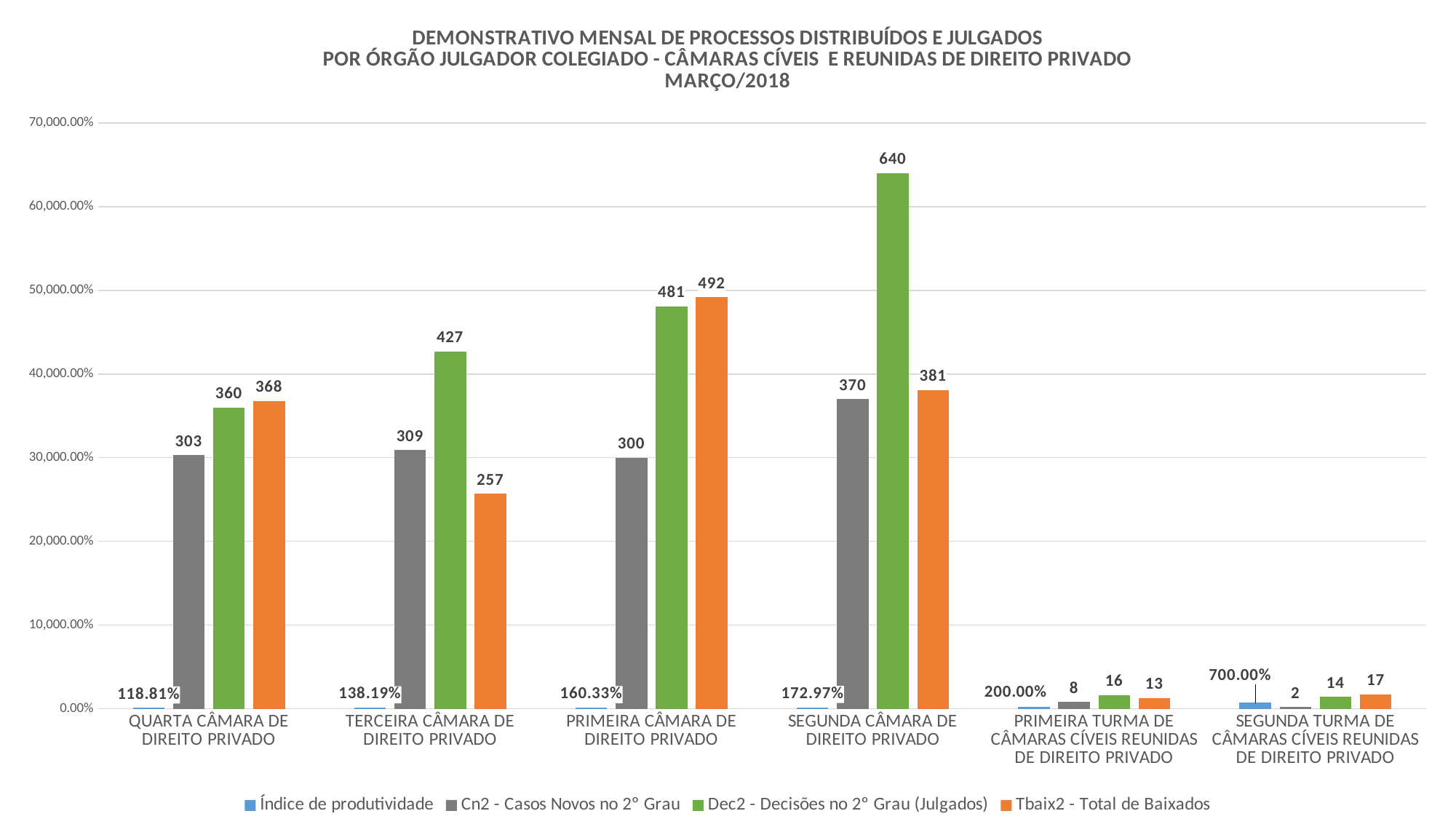
Which category has the lowest value for Cn2 - Casos Novos no 2° Grau? SEGUNDA TURMA DE CÂMARAS CÍVEIS REUNIDAS DE DIREITO PRIVADO What is the value of Tbaix2 - Total de Baixados for PRIMEIRA CÂMARA DE DIREITO PRIVADO? 492 What is the difference between Dec2 - Decisões no 2° Grau (Julgados) and Cn2 - Casos Novos no 2° Grau for SEGUNDA CÂMARA DE DIREITO PRIVADO? 270 What is the value of Cn2 - Casos Novos no 2° Grau for SEGUNDA TURMA DE CÂMARAS CÍVEIS REUNIDAS DE DIREITO PRIVADO? 2 How many series does the legend list? 4 What is the Índice de produtividade for TERCEIRA CÂMARA DE DIREITO PRIVADO? 138.19% Which is larger for TERCEIRA CÂMARA DE DIREITO PRIVADO: Cn2 - Casos Novos no 2° Grau or Tbaix2 - Total de Baixados? Cn2 - Casos Novos no 2° Grau Which series is shown in orange in the legend? Tbaix2 - Total de Baixados Which category has the highest value for Dec2 - Decisões no 2° Grau (Julgados)? SEGUNDA CÂMARA DE DIREITO PRIVADO How many categories are shown on the x axis? 6 What kind of chart is shown on the slide? Bar chart What is the value of Dec2 - Decisões no 2° Grau (Julgados) for SEGUNDA CÂMARA DE DIREITO PRIVADO? 640